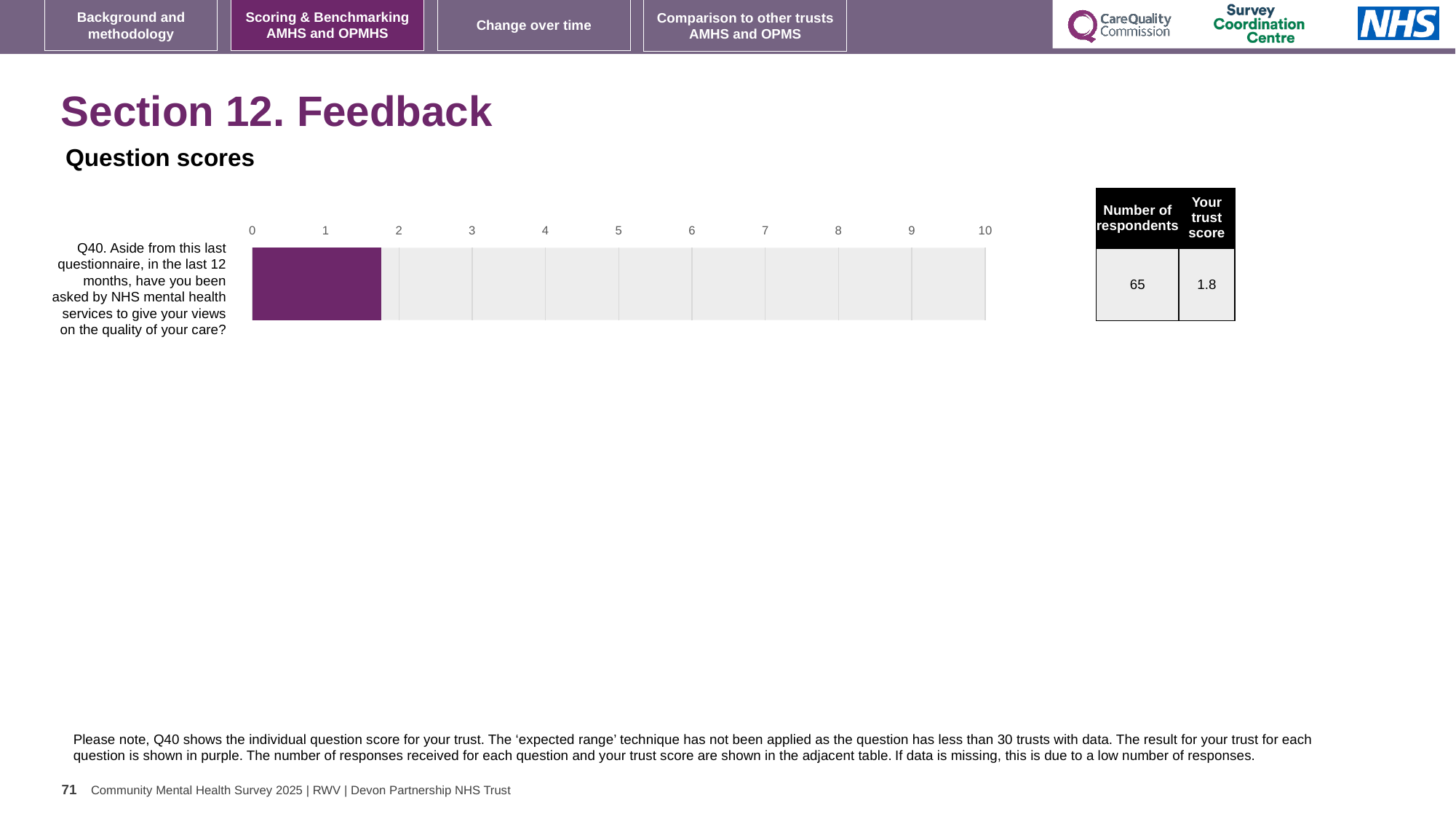
Is the value of the bar for Q40 greater or less than 2? less Is the value of the bar for Q40 greater or less than 5? less Is the value of the bar for Q40 greater or less than 1? greater What colour is the bar for Q40? purple What kind of chart is shown on the slide? bar chart What is the trust score for Q40 shown in the adjacent table? 1.8 How many questions (categories) are plotted in the chart? 1 What is the highest value shown on the chart's horizontal axis? 10 How many respondents are listed for Q40 in the table next to the chart? 65